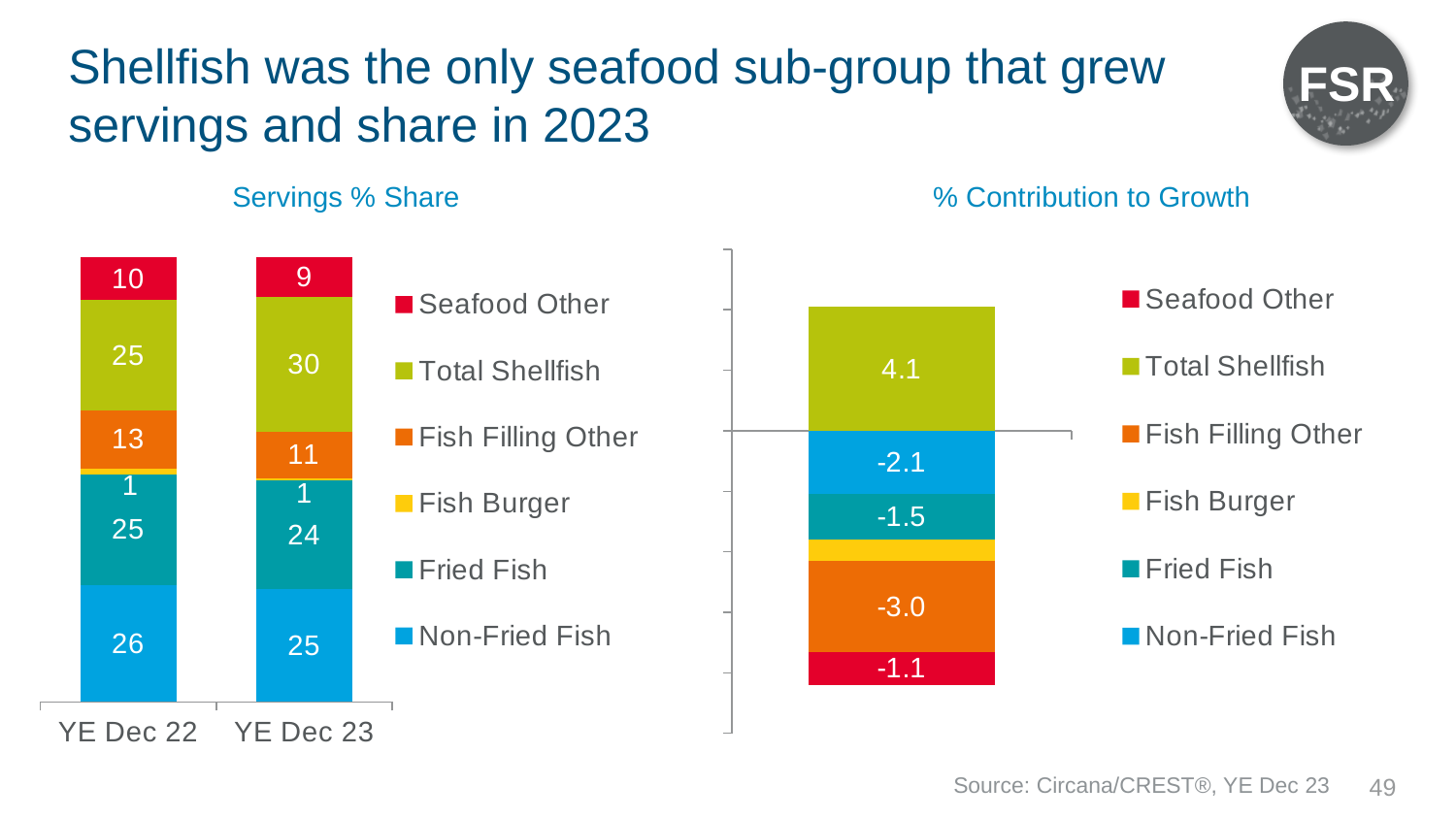
In the Servings % Share chart, which segment is the smallest in YE Dec 22? Fish Burger How many series does the legend of the Servings % Share chart list? 6 In the Servings % Share chart, by how much did Total Shellfish change from YE Dec 22 to YE Dec 23? 5 In the % Contribution to Growth chart, what is the value for Total Shellfish? 4.1 What kind of chart is the % Contribution to Growth chart? Stacked bar chart In the % Contribution to Growth chart, which series has the lowest value? Fish Filling Other In the % Contribution to Growth chart, what is the value for Fish Filling Other? -3.0 In the Servings % Share chart, what is the value for Total Shellfish in YE Dec 23? 30 In the Servings % Share chart, what is the value for Non-Fried Fish in YE Dec 22? 26 In the Servings % Share chart, is Seafood Other larger in YE Dec 22 or YE Dec 23? YE Dec 22 In the Servings % Share chart, what is the value for Fish Filling Other in YE Dec 23? 11 In the Servings % Share chart, how many bars are plotted? 2